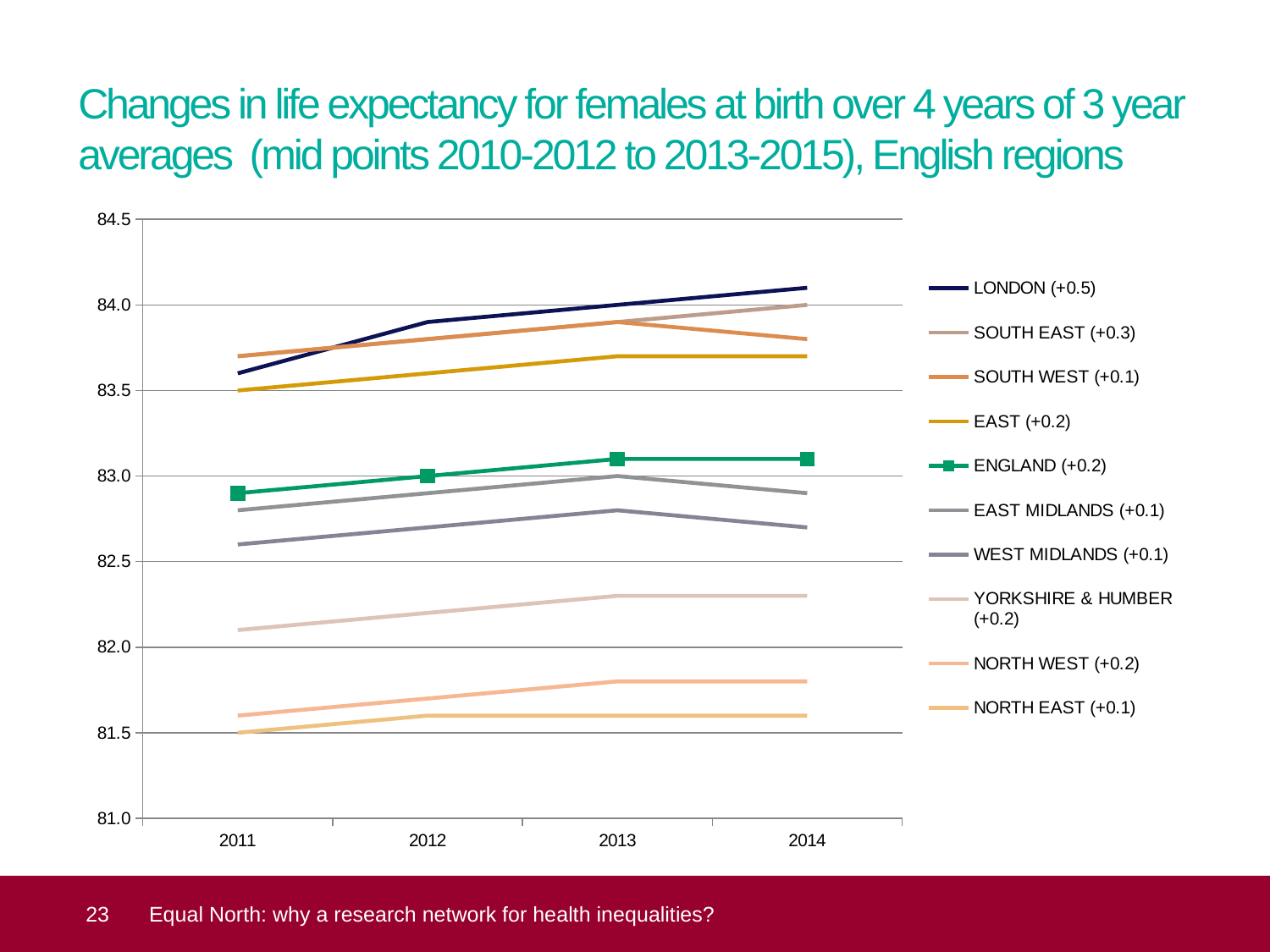
According to the legend, what change in life expectancy is shown for LONDON? +0.5 Is the value for NORTH WEST in 2014 greater or less than 82.0? less In 2013, which is higher: ENGLAND or WEST MIDLANDS? ENGLAND How many series does the legend list? 10 What kind of chart is shown on the slide? line chart According to the legend, what change in life expectancy is shown for YORKSHIRE & HUMBER? +0.2 Is the value for YORKSHIRE & HUMBER in 2014 greater or less than 82.5? less How many years are shown along the x axis? 4 Does the LONDON line rise or fall from 2011 to 2014? rise Which series has the lowest value in 2014? NORTH EAST Which region has the largest change shown in the legend? LONDON (+0.5) Is the value for LONDON in 2014 greater or less than 83.5? greater